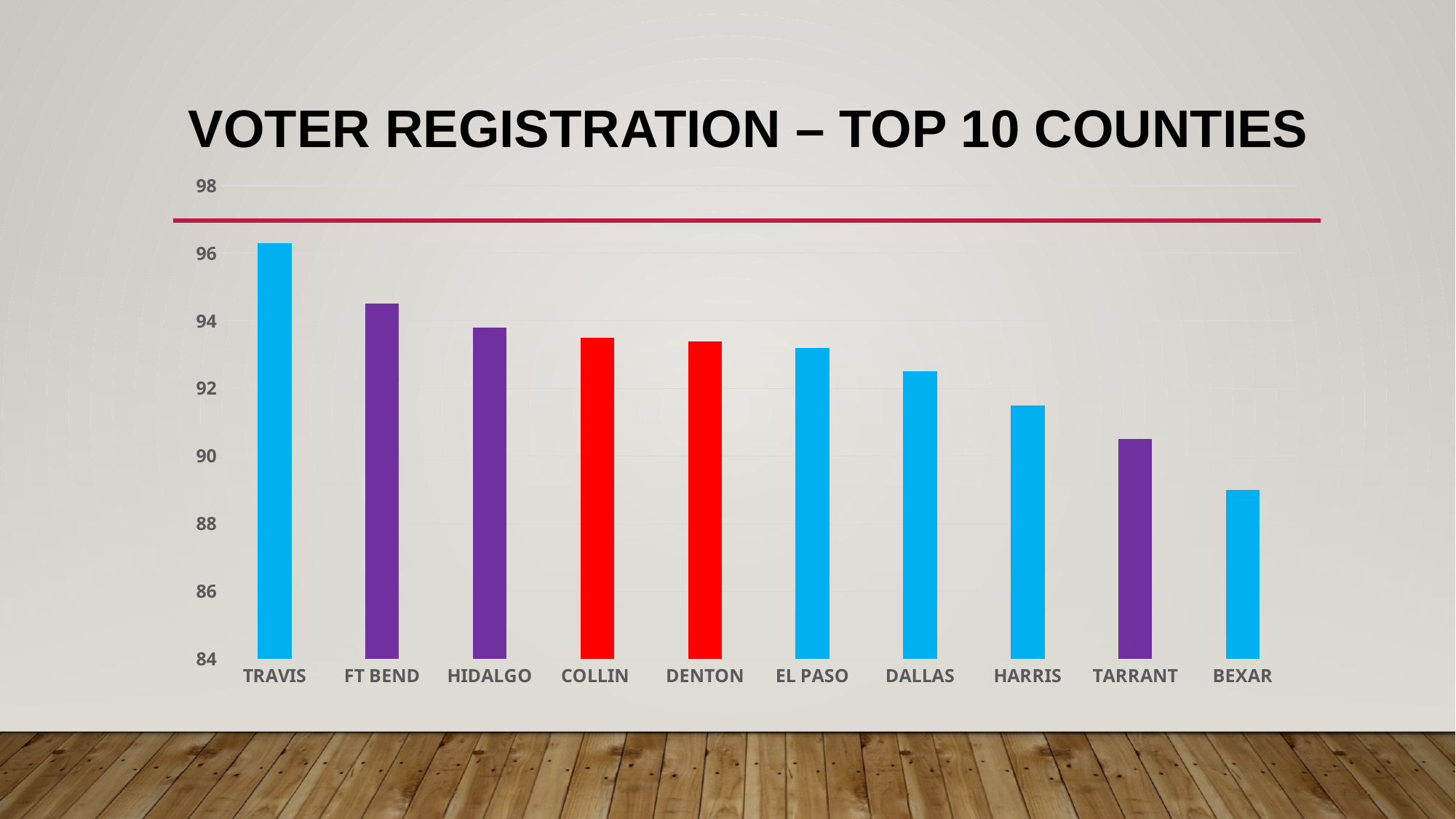
Is the value for El Paso greater or less than 94? less Do the values rise or fall moving from left to right along the x axis? Fall Is the value for Bexar greater or less than 90? less What kind of chart is shown on the slide? Bar chart Which has the larger value, Tarrant or Harris? Harris What is the title of the chart? Voter Registration – Top 10 Counties Which county has the lowest voter registration value? Bexar Which county has the highest voter registration value? Travis Is the value for Travis greater or less than 94? greater Which has the larger value, Ft Bend or Hidalgo? Ft Bend How many counties are shown in the chart? 10